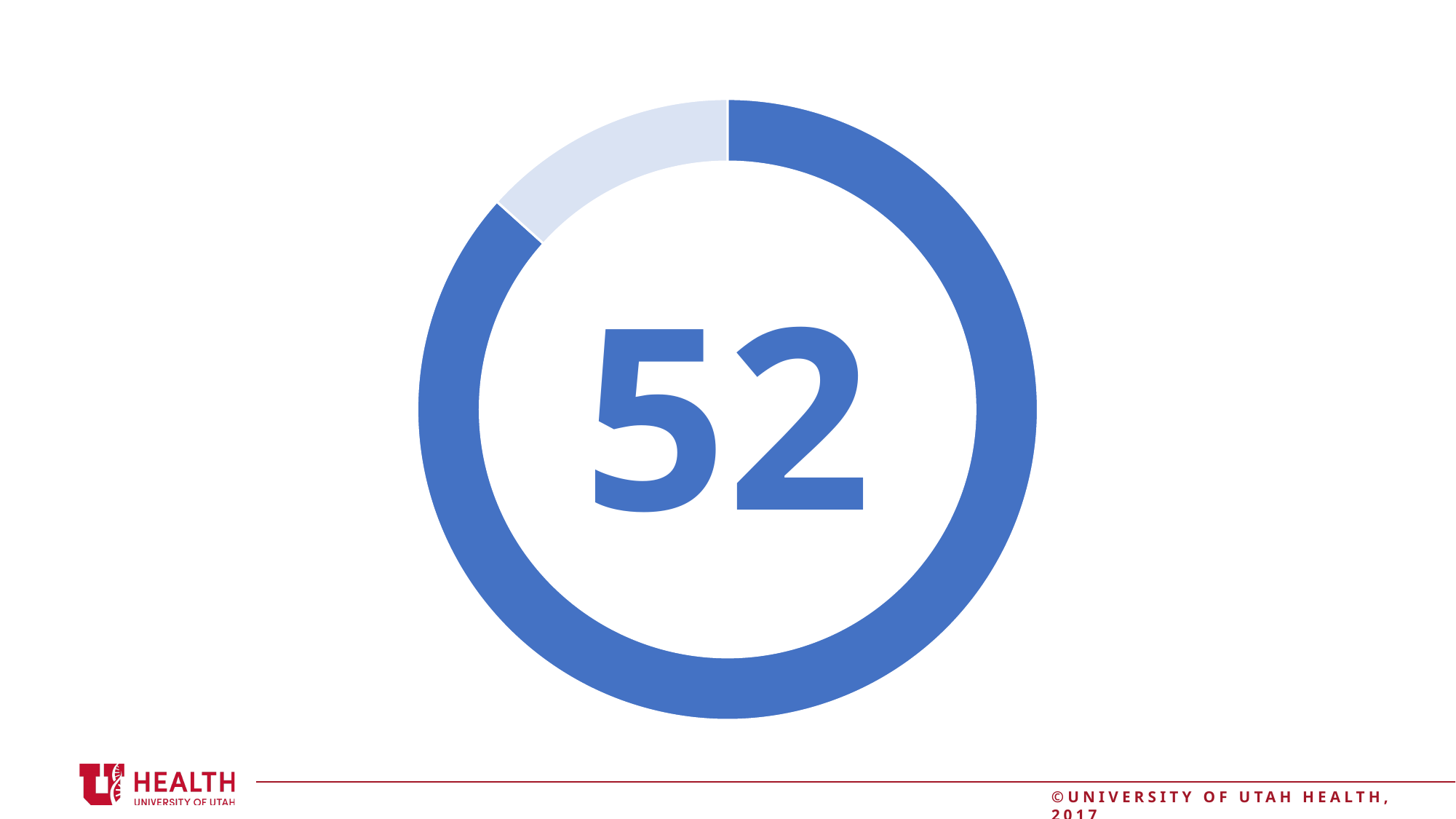
Does the dark blue segment cover more or less than half of the ring? More How many segments does the doughnut chart have? 2 Which segment of the doughnut chart is the smallest? The light blue segment What kind of chart is shown on the slide? Doughnut chart Which segment of the doughnut chart is larger, the dark blue one or the light blue one? Dark blue Does the doughnut chart display a legend? No What number is displayed in the centre of the doughnut chart? 52